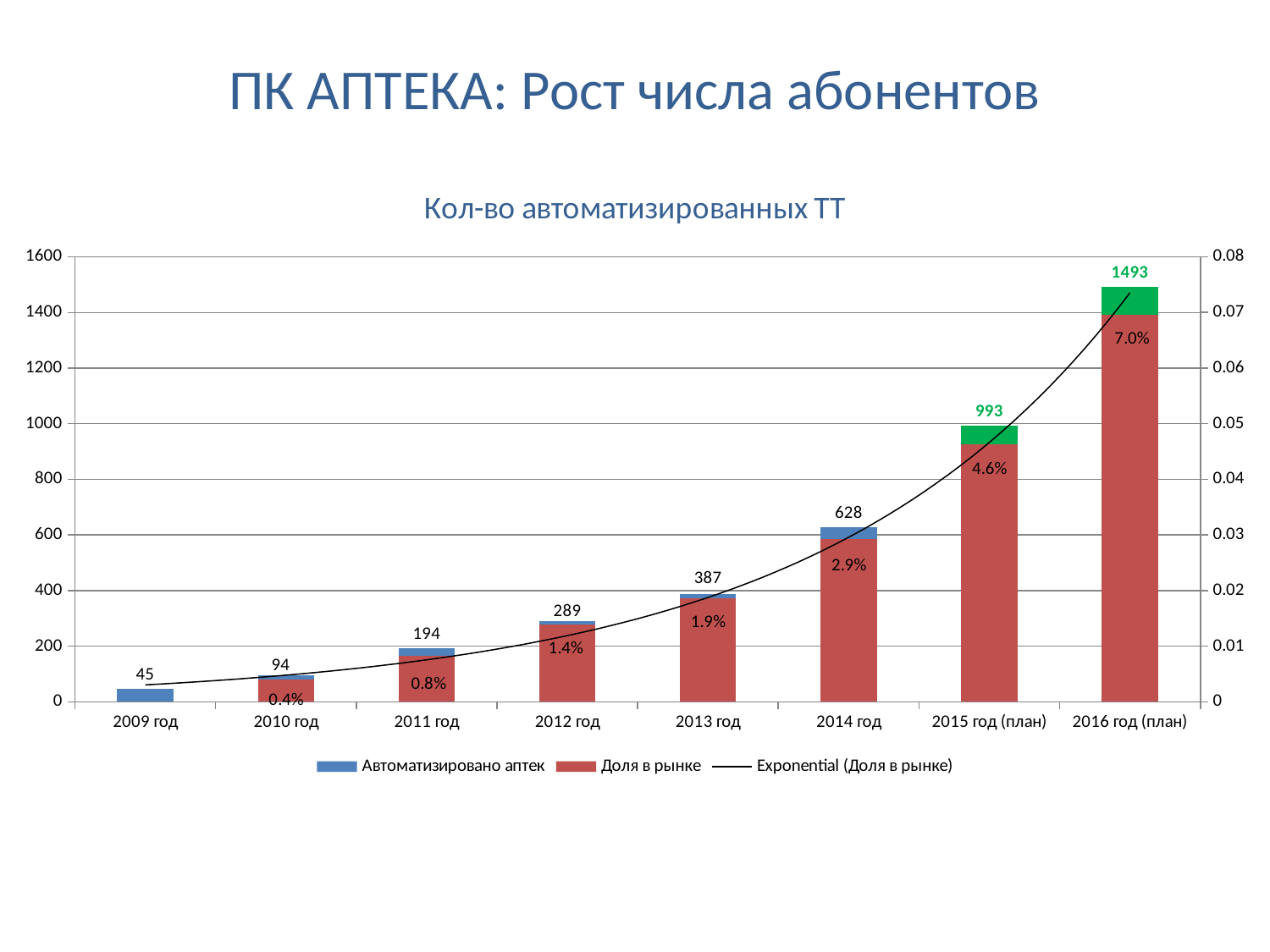
What market share percentage is shown for 2015 год (план)? 4.6% What kind of chart is this? Bar chart with a line Do the labelled values rise or fall from 2009 год to 2016 год (план)? Rise Which year has the lowest labelled value? 2009 год What is the difference between the labelled values for 2015 год (план) and 2014 год? 365 Which is larger, the labelled value for 2012 год or for 2013 год? 2013 год What is the value labelled for 2016 год (план)? 1493 Which year has the highest labelled value? 2016 год (план) How many year categories are shown on the x axis? 8 What is the value labelled for 2014 год? 628 What market share (Доля в рынке) percentage is shown for 2013 год? 1.9% How many entries does the legend list? 3